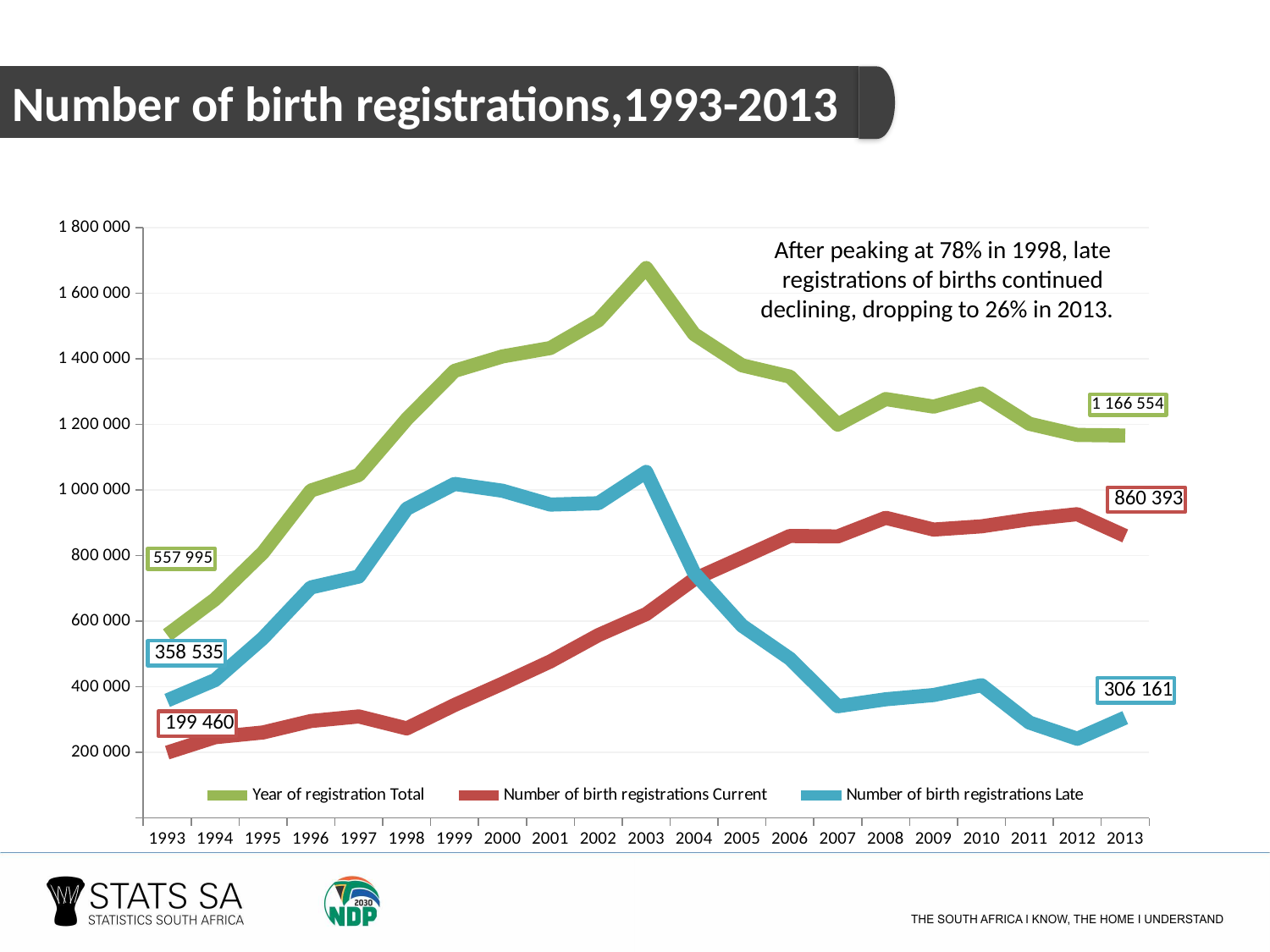
How many series does the legend list? 3 Is the value for Number of birth registrations Late in 2012 greater or less than 400 000? less What is the value for Year of registration Total in 1993? 557 995 What is the difference between Number of birth registrations Current in 2013 and in 1993? 660 933 In 1993, which is larger: Number of birth registrations Late or Number of birth registrations Current? Number of birth registrations Late What kind of chart is shown on the slide? Line chart What is the difference between the Year of registration Total in 2013 and in 1993? 608 559 Is the value for Number of birth registrations Late in 2003 greater or less than 1 000 000? greater What is the value for Year of registration Total in 2013? 1 166 554 What is the value for Number of birth registrations Late in 1993? 358 535 What is the value for Number of birth registrations Current in 2013? 860 393 In which year does the Year of registration Total line reach its highest value? 2003